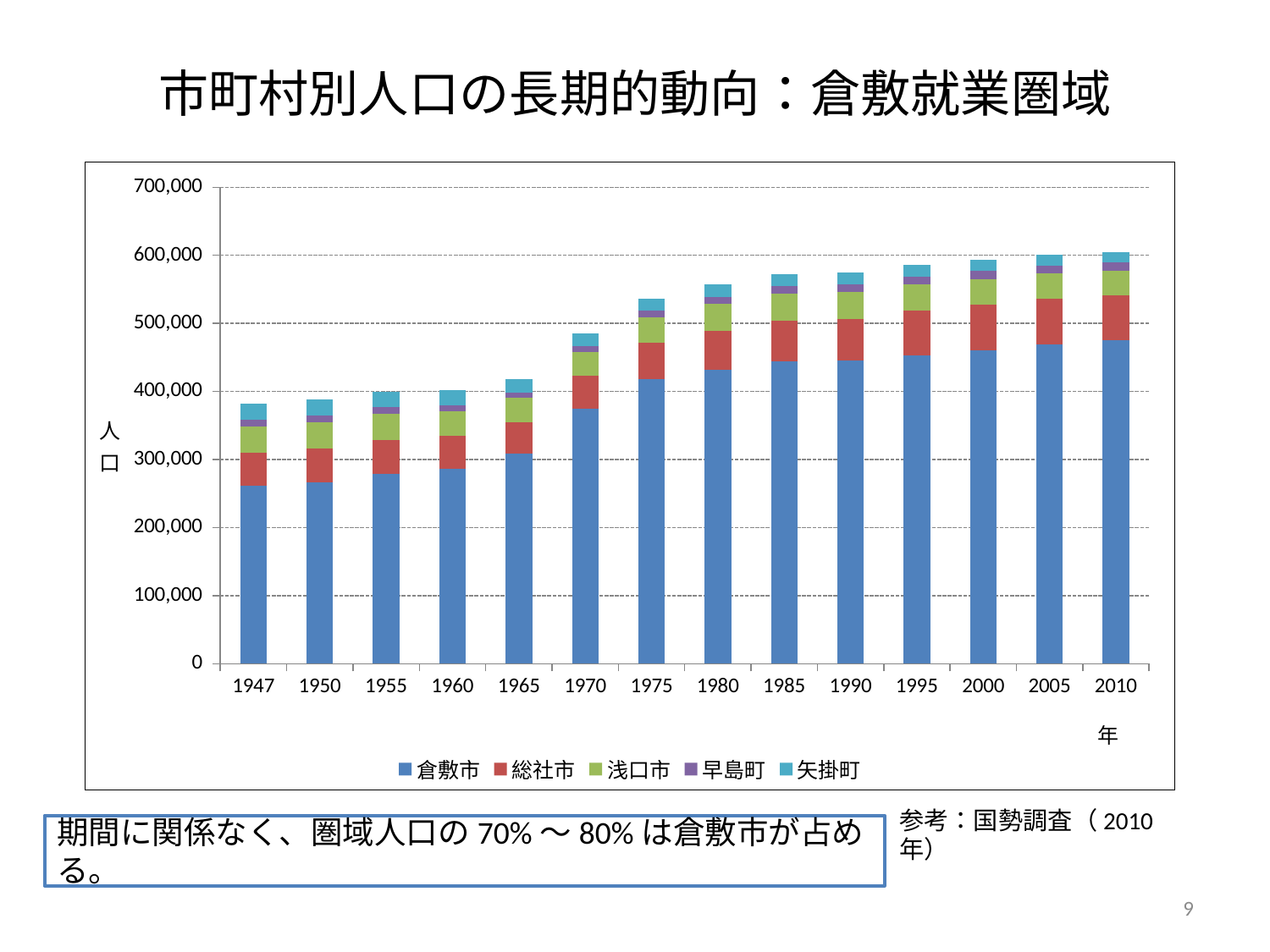
Is the value for 倉敷市 in 1947 greater or less than 300,000? less Is the total stacked value for 1947 greater or less than 400,000? less Which year has the larger total stacked value, 1960 or 1975? 1975 Does the total population of the stacked bars generally rise or fall from 1947 to 2010? Rise Is the total stacked value for 1975 greater or less than 500,000? greater How many series does the chart's legend list? 5 Which year has the larger total stacked value, 1965 or 1970? 1970 How many years are shown along the x axis of the chart? 14 What is the title of the chart on the slide? 市町村別人口の長期的動向：倉敷就業圏域 Which series is shown at the bottom of each stacked bar? 倉敷市 What kind of chart is shown on the slide? Stacked bar chart